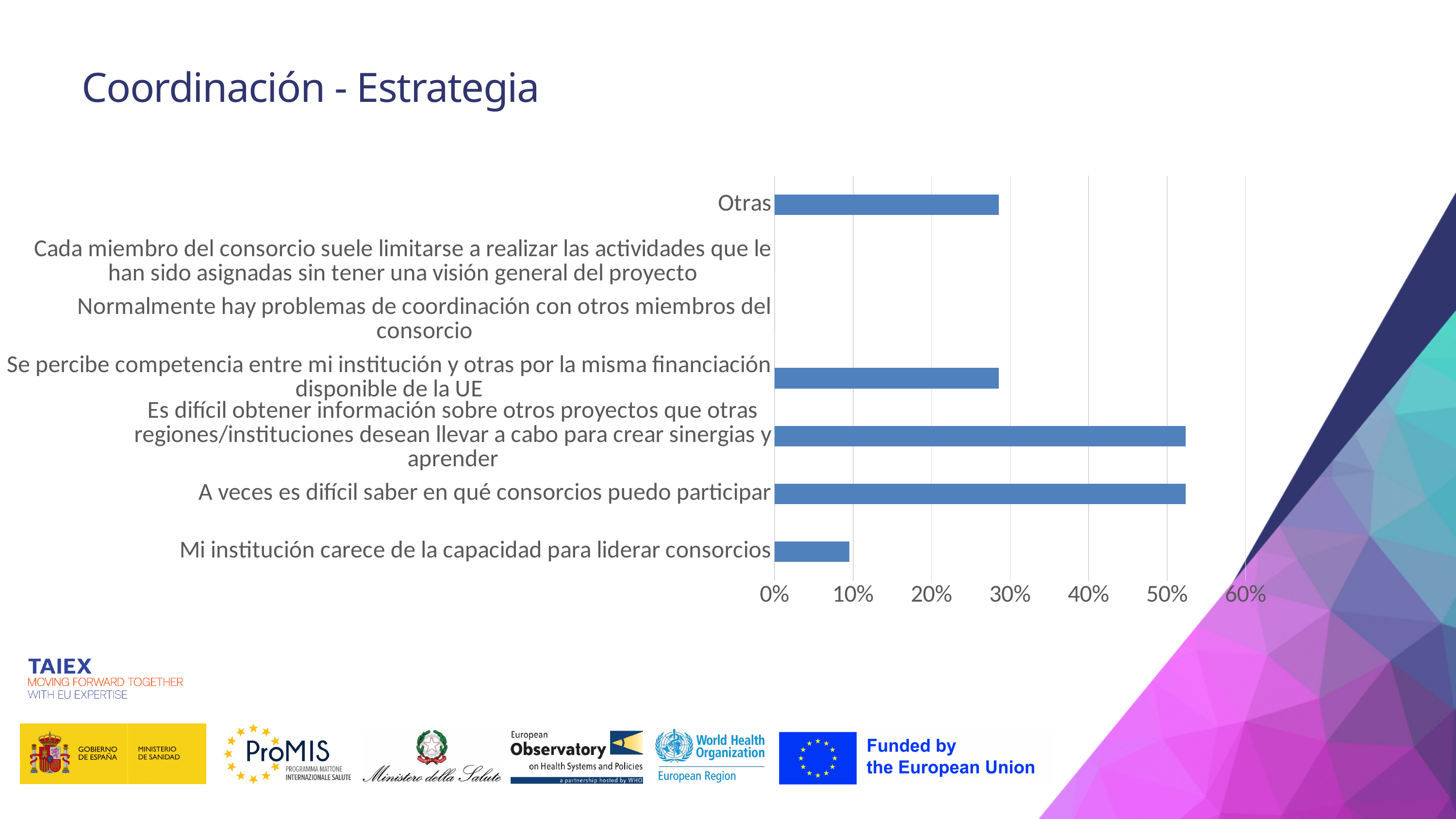
What is the highest value shown on the chart's horizontal axis? 60% Is the value for "Se percibe competencia entre mi institución y otras por la misma financiación disponible de la UE" greater or less than 40%? less Which has the larger value: "A veces es difícil saber en qué consorcios puedo participar" or "Otras"? A veces es difícil saber en qué consorcios puedo participar What kind of chart is shown on the slide? Bar chart What is the title of the slide containing the chart? Coordinación - Estrategia Which has the larger value: "Se percibe competencia entre mi institución y otras por la misma financiación disponible de la UE" or "Mi institución carece de la capacidad para liderar consorcios"? Se percibe competencia entre mi institución y otras por la misma financiación disponible de la UE How many categories are listed on the chart's vertical axis? 7 Is the value for "Mi institución carece de la capacidad para liderar consorcios" greater or less than 20%? less Is the value for "Es difícil obtener información sobre otros proyectos que otras regiones/instituciones desean llevar a cabo para crear sinergias y aprender" greater or less than 40%? greater Which has the larger value: "Es difícil obtener información sobre otros proyectos que otras regiones/instituciones desean llevar a cabo para crear sinergias y aprender" or "Mi institución carece de la capacidad para liderar consorcios"? Es difícil obtener información sobre otros proyectos que otras regiones/instituciones desean llevar a cabo para crear sinergias y aprender